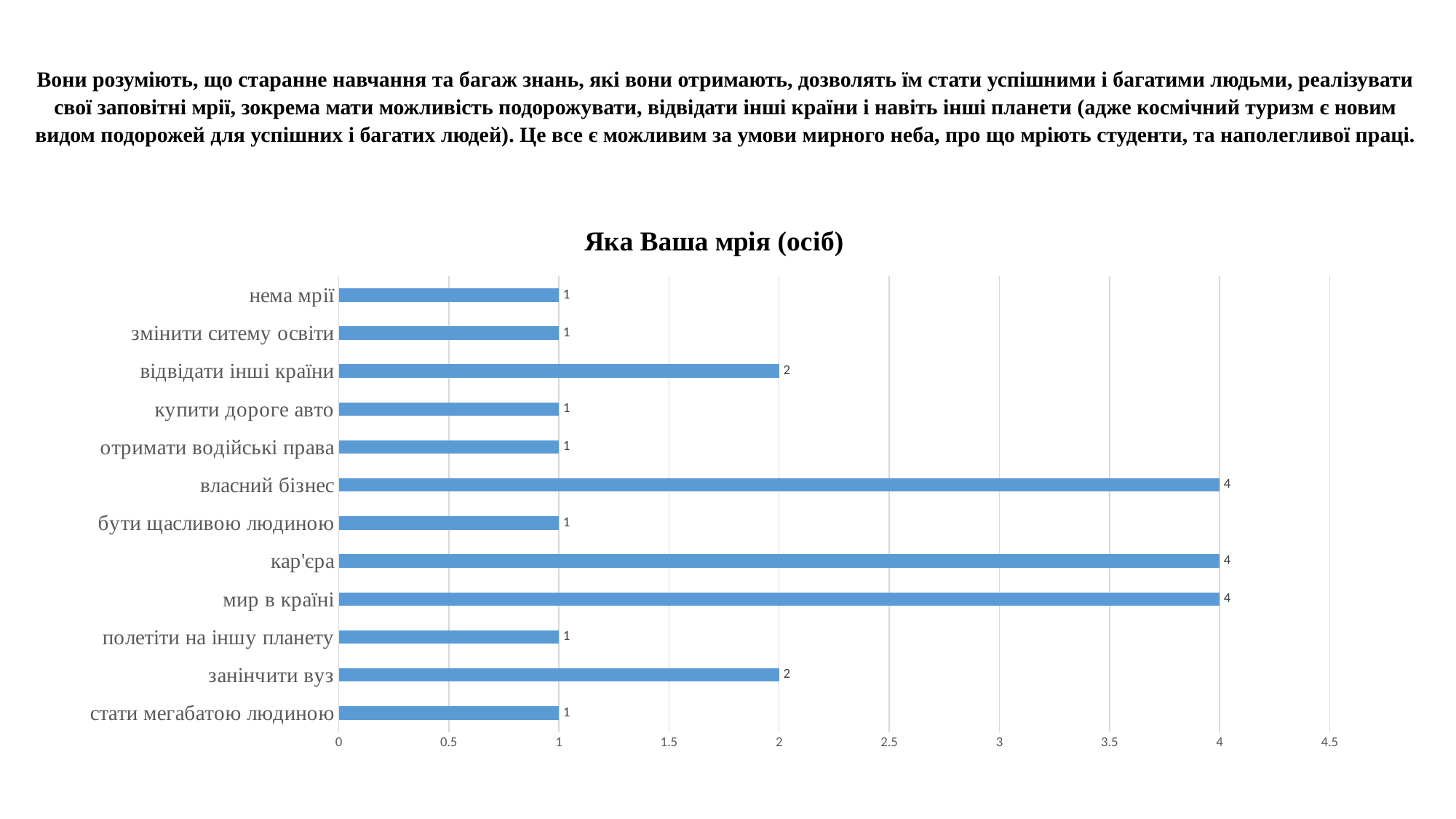
How many categories are plotted in the chart? 12 What is the title of the chart? Яка Ваша мрія (осіб) What is the value for "нема мрії"? 1 Which has a larger value, "відвідати інші країни" or "купити дороге авто"? відвідати інші країни What is the highest value shown in the chart? 4 What is the value for "мир в країні"? 4 What is the value for "занінчити вуз"? 2 What is the difference between the values for "кар'єра" and "полетіти на іншу планету"? 3 Is the value for "власний бізнес" greater or less than 3? greater What type of chart is shown on the slide? bar chart What is the value for "власний бізнес"? 4 What is the value for "відвідати інші країни"? 2